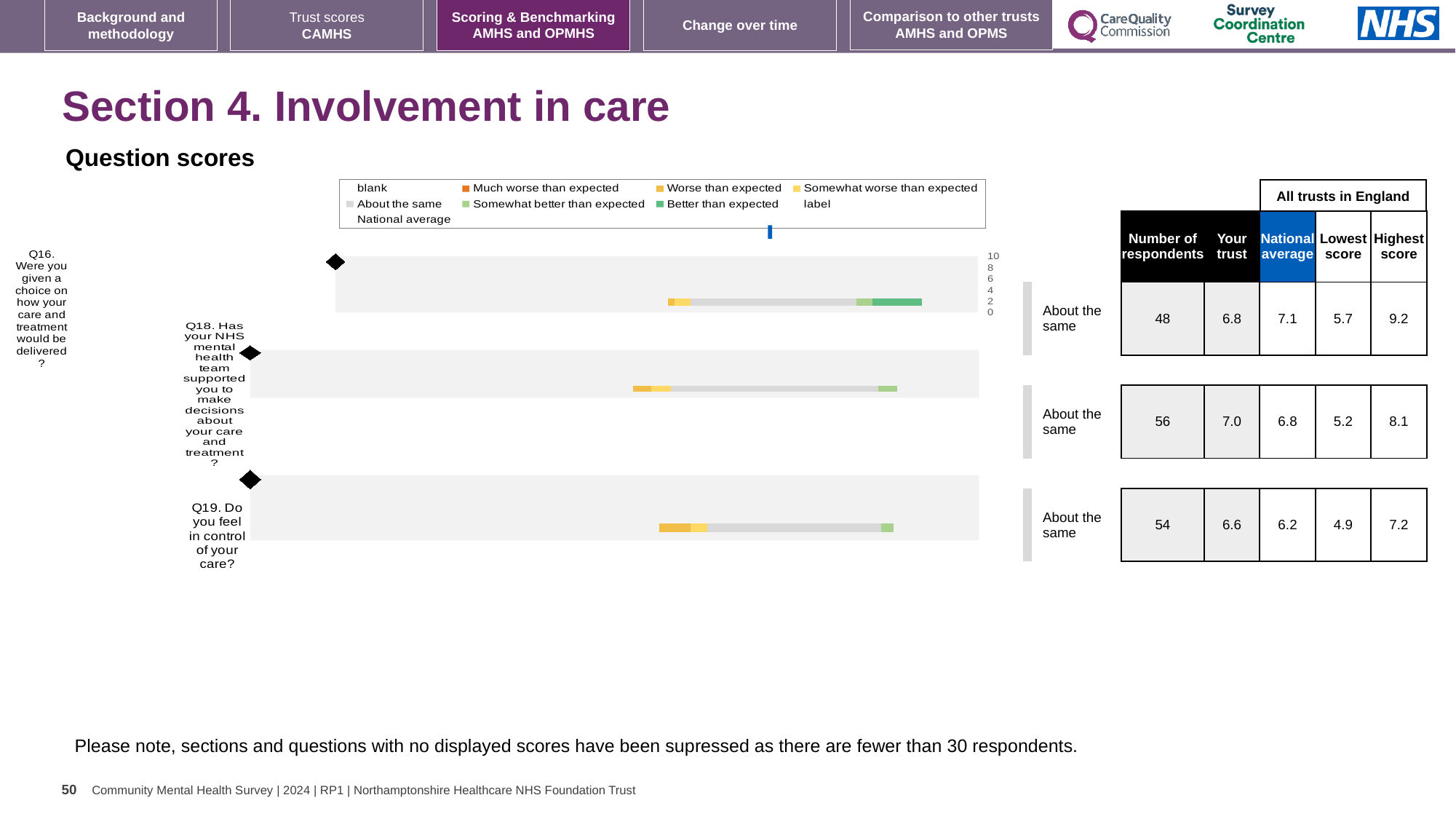
What is the number of respondents for Q16 in the table next to the chart? 48 How many questions are plotted in the question scores chart? 3 What is the difference between the highest score and the lowest score for Q16? 3.5 What comparison label is shown beside the bar for Q18? About the same For Q19, which is larger: the 'Your trust' score or the national average? Your trust What kind of chart is used to show the question scores on this slide? bar chart What is the national average score for Q19? 6.2 Which question has the lowest number of respondents? Q16 Which question has the highest 'Your trust' score? Q18 What is the 'Your trust' score for Q18? 7.0 What is the title of the chart section on this slide? Question scores What is the highest score across all trusts in England for Q16? 9.2